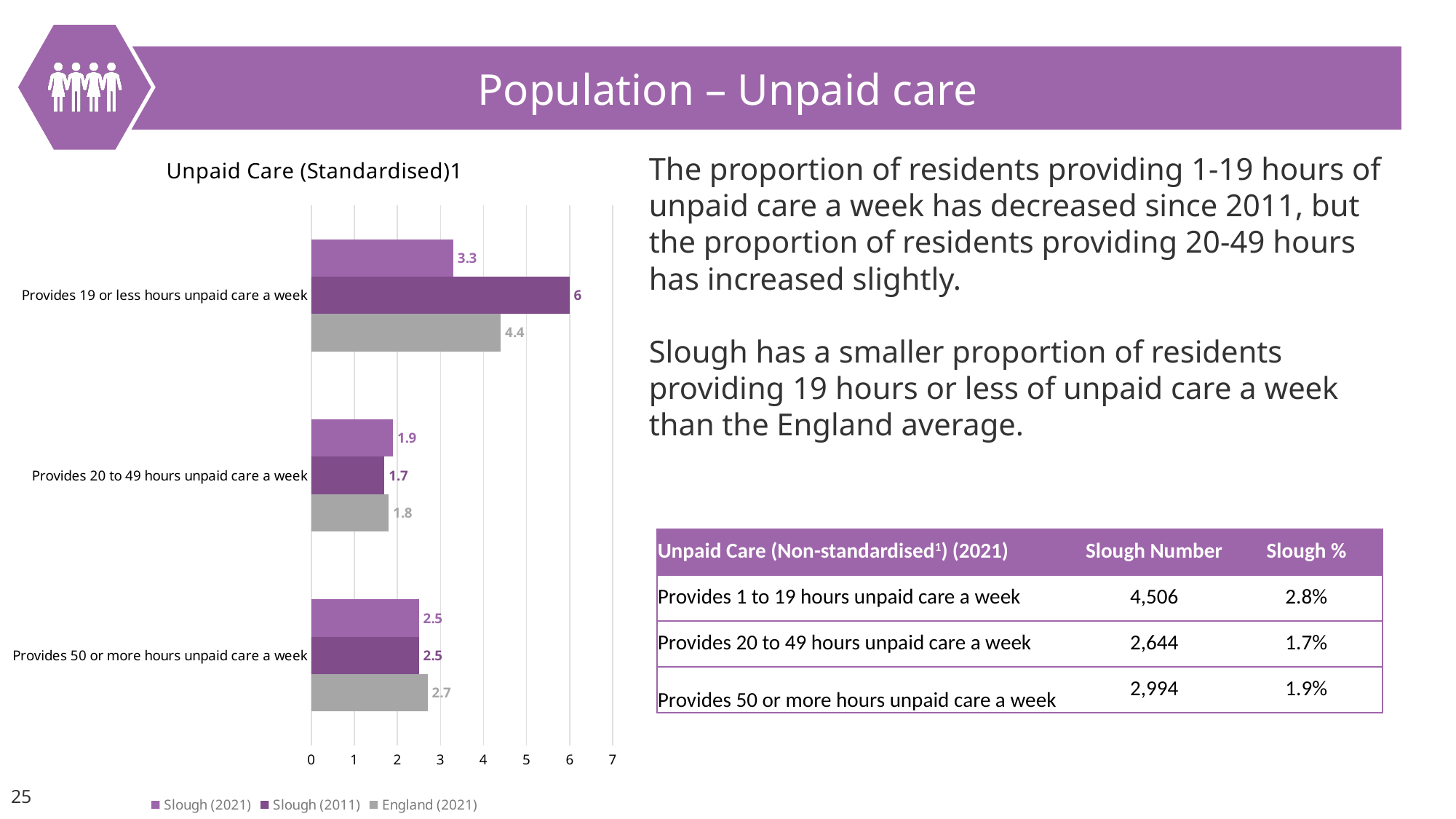
What is the title of the chart? Unpaid Care (Standardised)1 How many series does the chart legend list? 3 What is the England (2021) value for 'Provides 50 or more hours unpaid care a week'? 2.7 How many categories are shown on the chart? 3 What is the Slough (2021) value for 'Provides 19 or less hours unpaid care a week'? 3.3 Which category has the highest Slough (2011) value? Provides 19 or less hours unpaid care a week Which category has the lowest Slough (2021) value? Provides 20 to 49 hours unpaid care a week For 'Provides 19 or less hours unpaid care a week', which is larger: the Slough (2021) value or the England (2021) value? England (2021) What is the Slough (2011) value for 'Provides 19 or less hours unpaid care a week'? 6 What type of chart is shown on the slide? Bar chart What is the difference between the Slough (2011) and Slough (2021) values for 'Provides 19 or less hours unpaid care a week'? 2.7 What is the England (2021) value for 'Provides 20 to 49 hours unpaid care a week'? 1.8